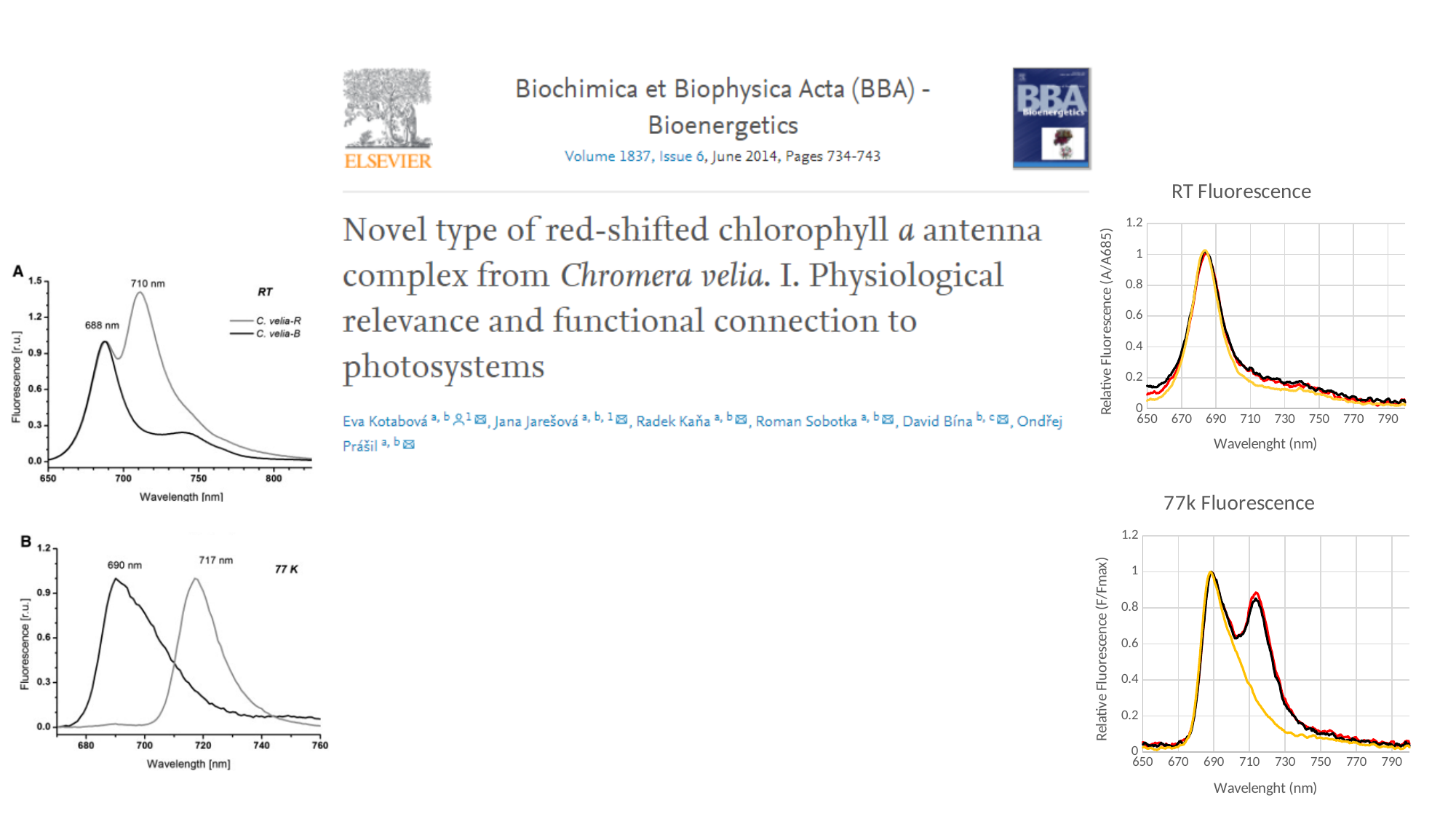
In the '77k Fluorescence' chart, is the value of the yellow curve at 730 nm greater or less than 0.4? less In chart A (RT) on the left, is the peak fluorescence of the C. velia-R curve greater or less than 1.2? greater In chart A (RT) on the left, at what wavelength is the peak of the C. velia-R curve labelled? 710 nm In chart A (RT) on the left, at what wavelength is the peak of the C. velia-B curve labelled? 688 nm In the 'RT Fluorescence' chart, do the values rise or fall as wavelength increases from 710 nm to 790 nm? fall In chart A (RT) on the left, which series reaches the higher peak fluorescence, C. velia-R or C. velia-B? C. velia-R In chart B (77 K) on the left, which labelled peak is at the longer wavelength? 717 nm In chart B (77 K) on the left, what is the difference in wavelength between the two labelled peaks, 717 nm and 690 nm? 27 nm In the 'RT Fluorescence' chart, is the relative fluorescence at 750 nm greater or less than 0.4? less How many series does the legend of chart A (RT) on the left list? 2 What is the y-axis label of the '77k Fluorescence' chart? Relative Fluorescence (F/Fmax) What kind of chart is the 'RT Fluorescence' chart on the right of the slide? line chart